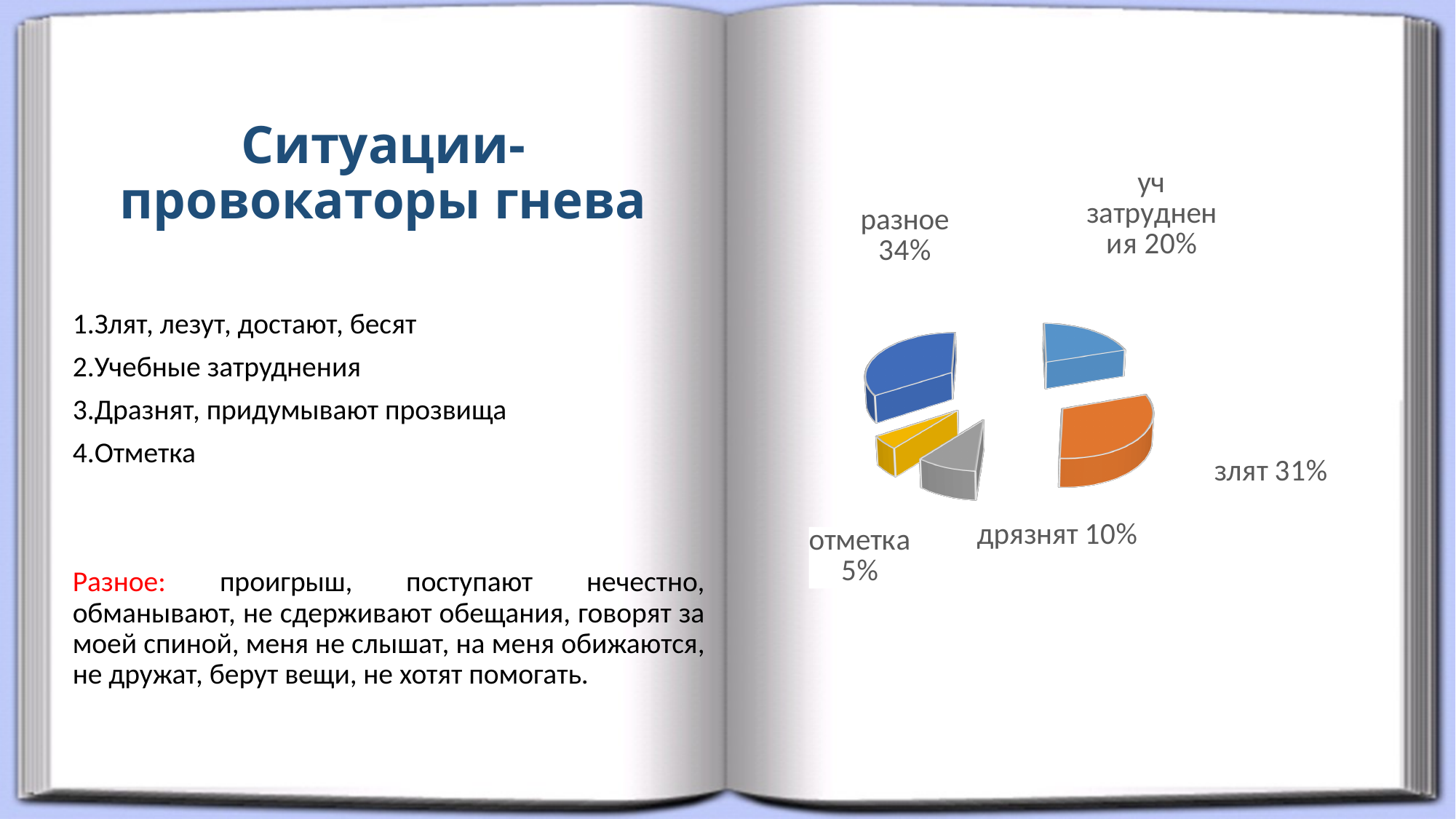
Which slice of the pie chart is the smallest? отметка What share of the pie does the "дрязнят" slice represent? 10% What colour is the "злят" slice in the pie chart? orange What share of the pie does the "отметка" slice represent? 5% Which slice of the pie chart is the largest? разное What is the difference in percentage points between the "разное" and "злят" slices? 3 What kind of chart is shown on the slide? pie chart How many slices does the pie chart have? 5 Which is larger, the "уч затруднения" slice or the "дрязнят" slice? уч затруднения What share of the pie does the "злят" slice represent? 31%